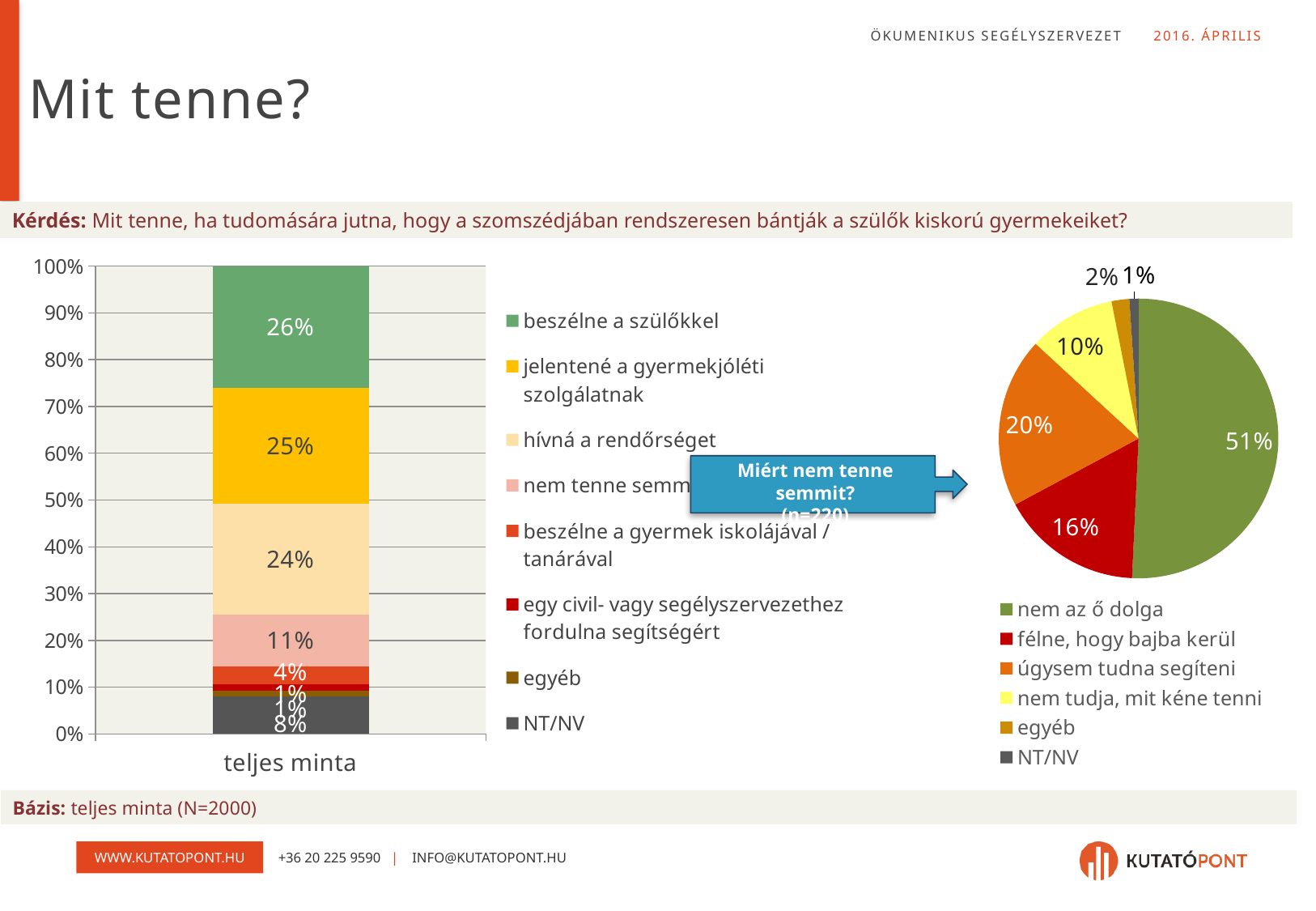
How many categories does the legend of the pie chart on the right list? 6 In the pie chart on the right, which is larger: 'félne, hogy bajba kerül' or 'nem tudja, mit kéne tenni'? félne, hogy bajba kerül In the stacked bar chart on the left, which response has the largest share? beszélne a szülőkkel In the stacked bar chart on the left, what percentage would call the police (hívná a rendőrséget)? 24% In the stacked bar chart on the left, what percentage would do nothing (nem tenne semmit)? 11% In the pie chart on the right, what share is 'úgysem tudna segíteni'? 20% In the stacked bar chart on the left, how many series does the legend list? 8 In the pie chart on the right, which category has the smallest slice? NT/NV In the stacked bar chart on the left, what percentage of the total sample would talk to the parents (beszélne a szülőkkel)? 26% In the stacked bar chart on the left, what is the difference between 'jelentené a gyermekjóléti szolgálatnak' and 'nem tenne semmit'? 14% What type of chart is the chart on the left of the slide? stacked bar chart In the pie chart on the right, what share is 'nem az ő dolga'? 51%